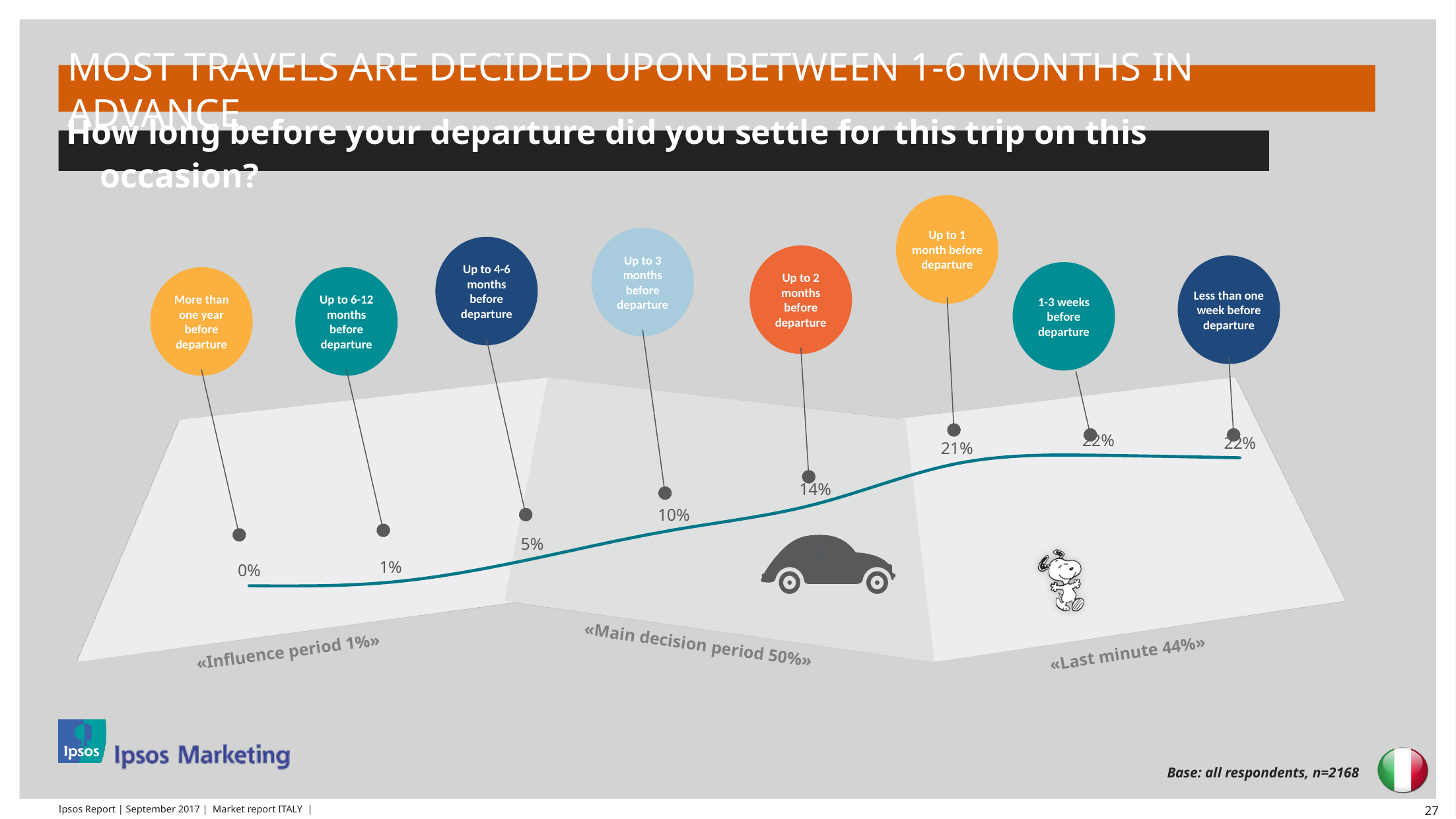
What percentage of respondents settled for the trip up to 3 months before departure? 10% What percentage decided up to 1 month before departure? 21% What is the value for 'Up to 4-6 months before departure'? 5% How many time-period categories are plotted on the chart? 8 What kind of chart is used to show the percentages? Line chart What share is labelled for the «Main decision period»? 50% Which category has the lowest value? More than one year before departure What is the base size stated on the slide? n=2168 What is the value for 'Up to 2 months before departure'? 14% Which is larger: the value for 'Up to 6-12 months before departure' or 'Up to 3 months before departure'? Up to 3 months before departure Do the values rise or fall moving from 'More than one year before departure' to 'Less than one week before departure'? Rise What is the difference between the values for 'Up to 1 month before departure' and 'Up to 2 months before departure'? 7%